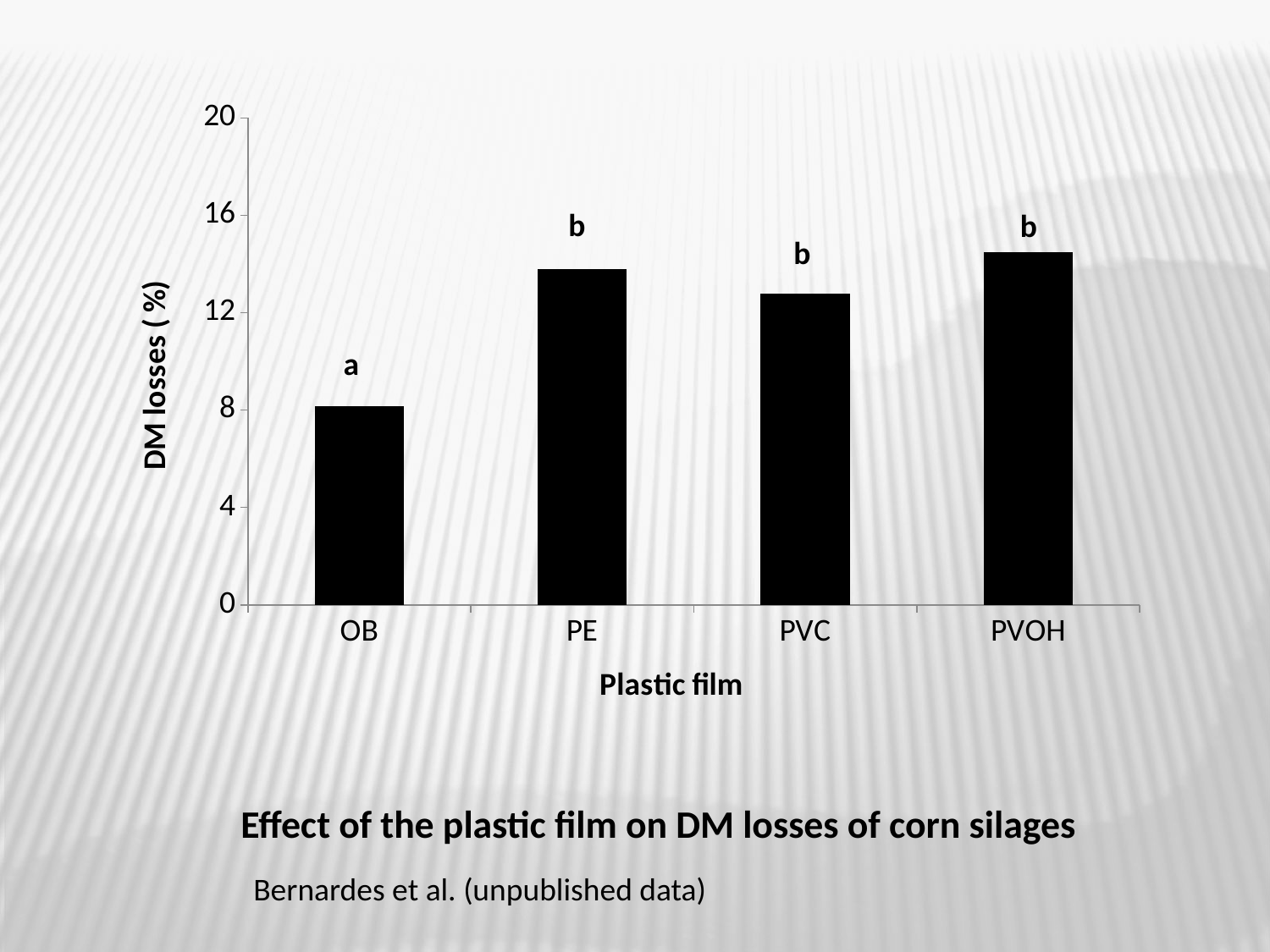
What letter is printed above the OB bar? a How many plastic film categories are plotted on the x axis? 4 Which has higher DM losses, OB or PVC? PVC Which plastic film has the lowest DM losses? OB Which has higher DM losses, PE or PVC? PE What is the title of the y axis? DM losses ( %) What kind of chart is shown on the slide? bar chart Is the value for OB greater or less than 12? less Is the value for PVC greater or less than 8? greater Which plastic film has the highest DM losses? PVOH Is the value for PE greater or less than 12? greater